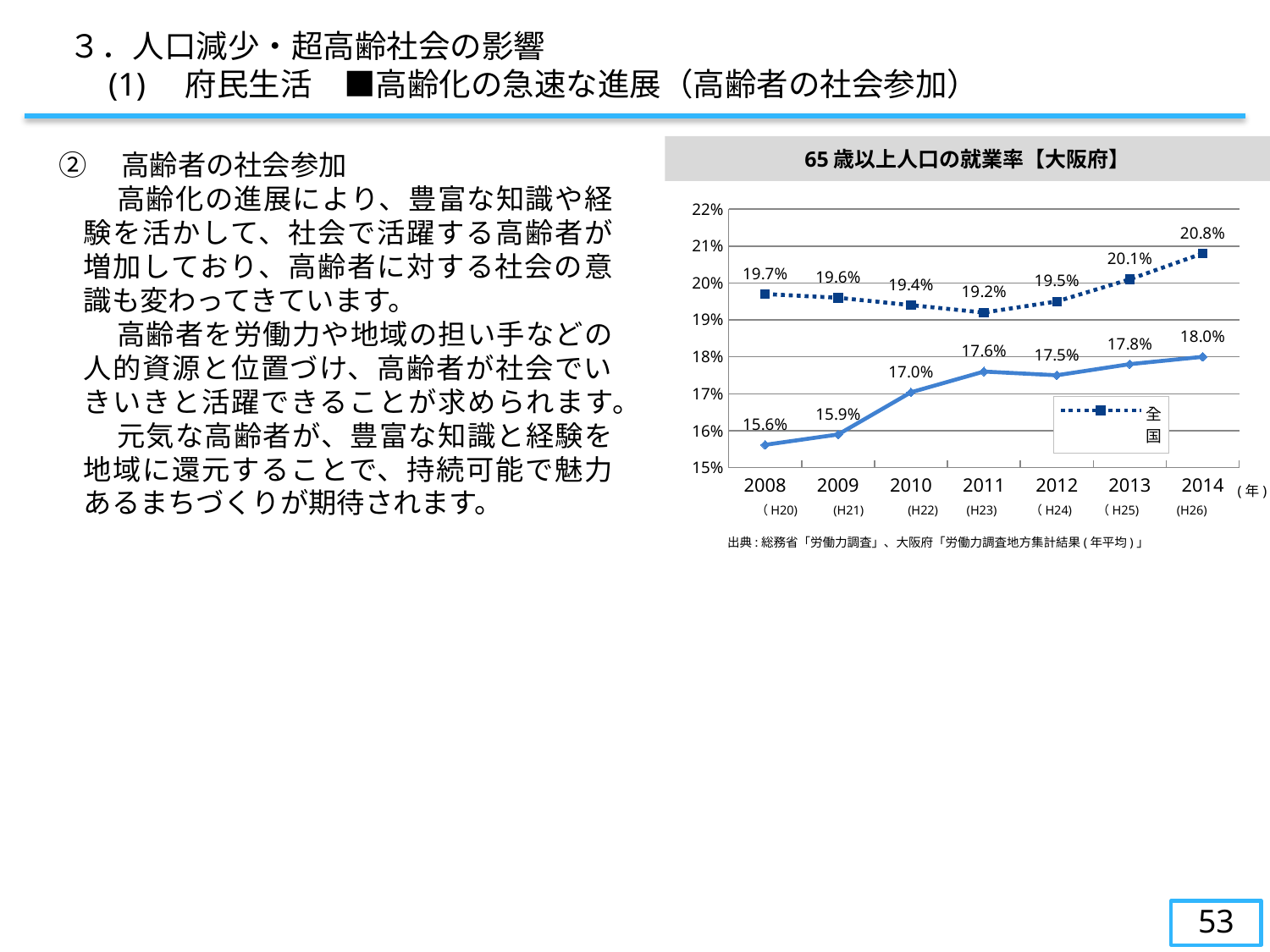
What is the title of the chart? 65歳以上人口の就業率【大阪府】 What kind of chart is shown on the slide? Line chart Does the solid-line series rise or fall from 2008 to 2014? Rise What is the difference between the 全国 value and the solid-line value in 2014? 2.8% What is the value of the 全国 (dotted) series in 2014? 20.8% In which year is the 全国 (dotted) series at its highest? 2014 How many series does the legend list? 1 What is the value of the solid-line series in 2011? 17.6% What is the value of the solid-line series in 2008? 15.6% How many years are plotted on the x axis? 7 In which year is the 全国 (dotted) series at its lowest? 2011 In 2010, which is larger: the 全国 (dotted) value or the solid-line value? 全国